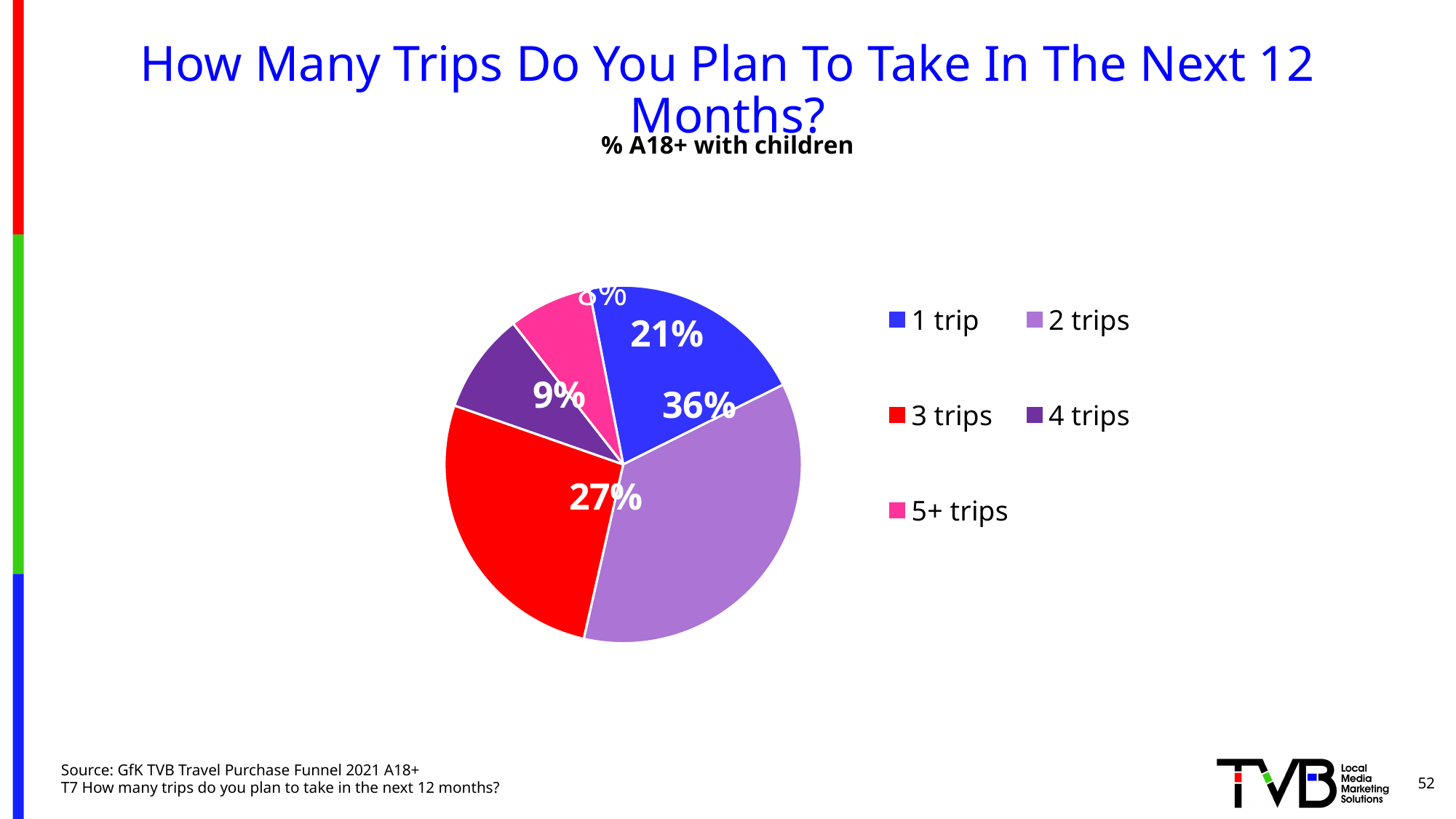
What is the difference between the 3 trips share and the 4 trips share? 18 percentage points What type of chart is shown on the slide? Pie chart What percentage of A18+ with children plan to take 1 trip in the next 12 months? 21% Which category has the smallest slice of the pie? 5+ trips What percentage of respondents plan to take 4 trips? 9% What colour represents 3 trips in the pie chart? Red How many percentage points larger is the 2 trips share than the 1 trip share? 15 percentage points Which number of trips has the largest share of the pie? 2 trips Which is larger: the share for 3 trips or the share for 1 trip? 3 trips What share of the pie is labelled for 3 trips? 27% How many categories does the pie chart show? 5 What percentage of respondents plan to take 2 trips? 36%